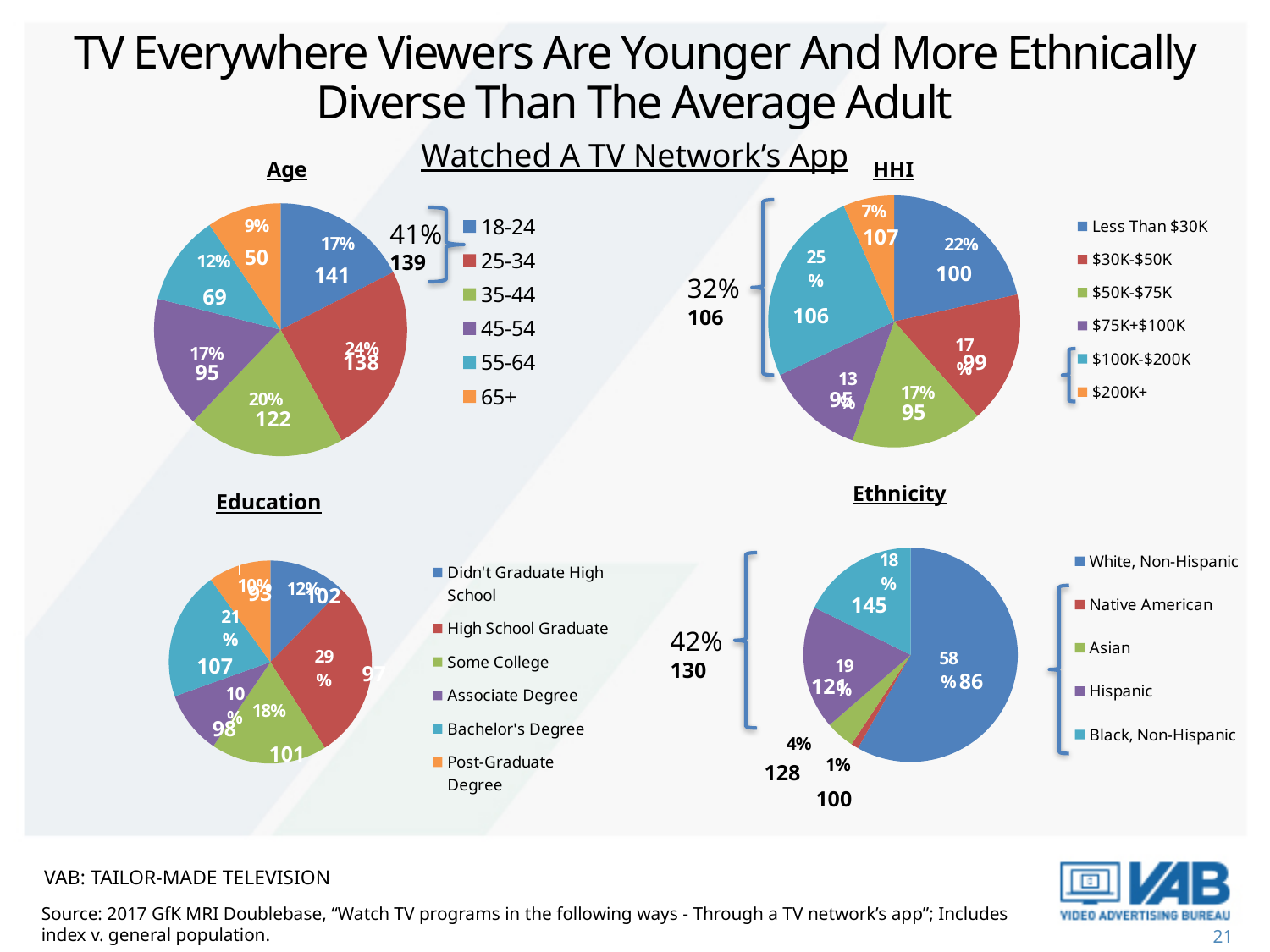
In the Ethnicity chart, what share of the pie is the White, Non-Hispanic slice? 58% In the Age chart, what share of the pie is the 65+ slice? 9% In the Education chart, which slice is larger: Bachelor's Degree or Some College? Bachelor's Degree In the Age chart, what is the difference in share between the 18-24 slice and the 55-64 slice? 5% In the Age chart, which age group has the largest slice? 25-34 How many entries does the legend of the Age chart list? 6 In the HHI chart, what index value is shown for the Less Than $30K slice? 100 In the HHI chart, what share of the pie is the $100K-$200K slice? 25% What kind of chart is the Age chart? pie chart How many entries does the legend of the Ethnicity chart list? 5 In the HHI chart, which income group has the smallest slice? $200K+